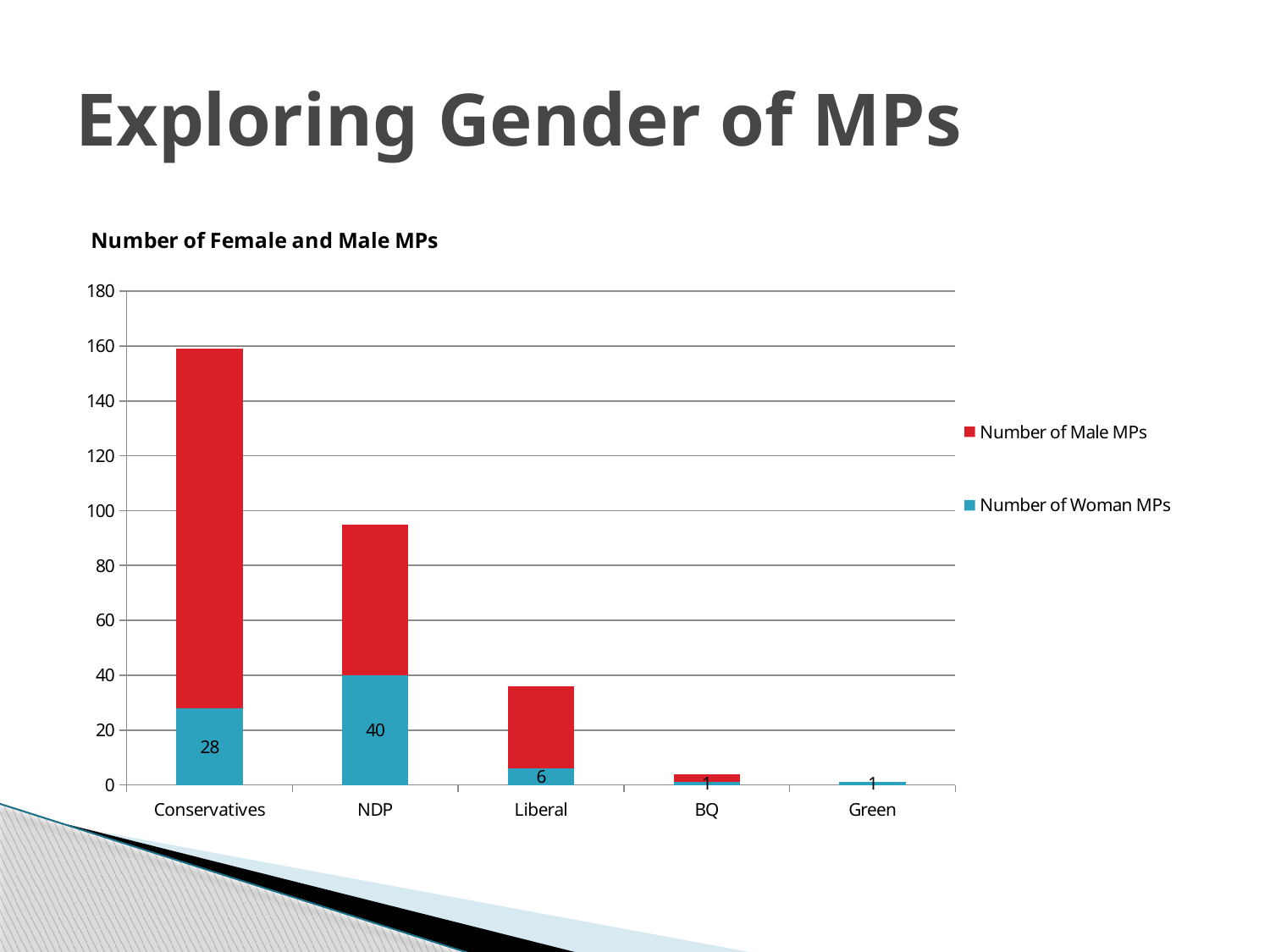
Which has more Woman MPs, the Conservatives or the Liberal party? Conservatives What is the Number of Woman MPs for the Conservatives? 28 Is the total height of the NDP bar greater or less than 100? less What is the Number of Woman MPs for the Liberal party? 6 What is the difference between the Number of Woman MPs for the NDP and for the Conservatives? 12 What is the Number of Woman MPs for the BQ? 1 What kind of chart is shown on the slide? Stacked bar chart Which party has the highest Number of Woman MPs? NDP How many series does the legend list? 2 Is the total height of the Conservatives bar greater or less than 140? greater How many parties are shown on the x axis? 5 What is the Number of Woman MPs for the NDP? 40